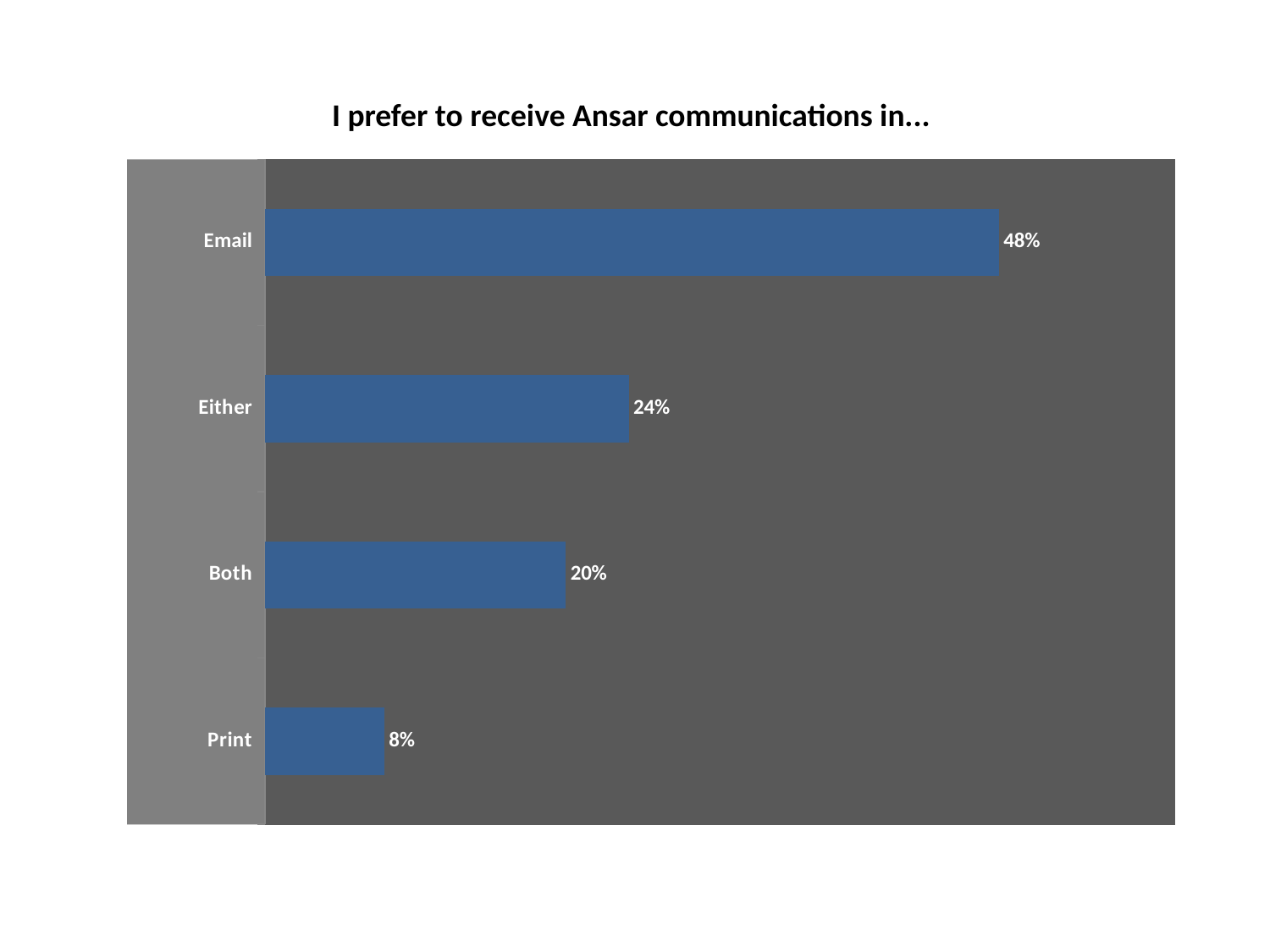
What is the value shown for Print? 8% What is the difference between the values for Email and Either? 24% Which is larger, the value for Either or the value for Both? Either How many categories are shown in the chart? 4 What kind of chart is shown on the slide? Bar chart What is the value shown for Either? 24% Which category has the lowest value? Print What is the value shown for Both? 20% What percentage of respondents prefer to receive Ansar communications by Email? 48% What is the title of the chart? I prefer to receive Ansar communications in... Which category has the highest value? Email What is the difference between the values for Both and Print? 12%